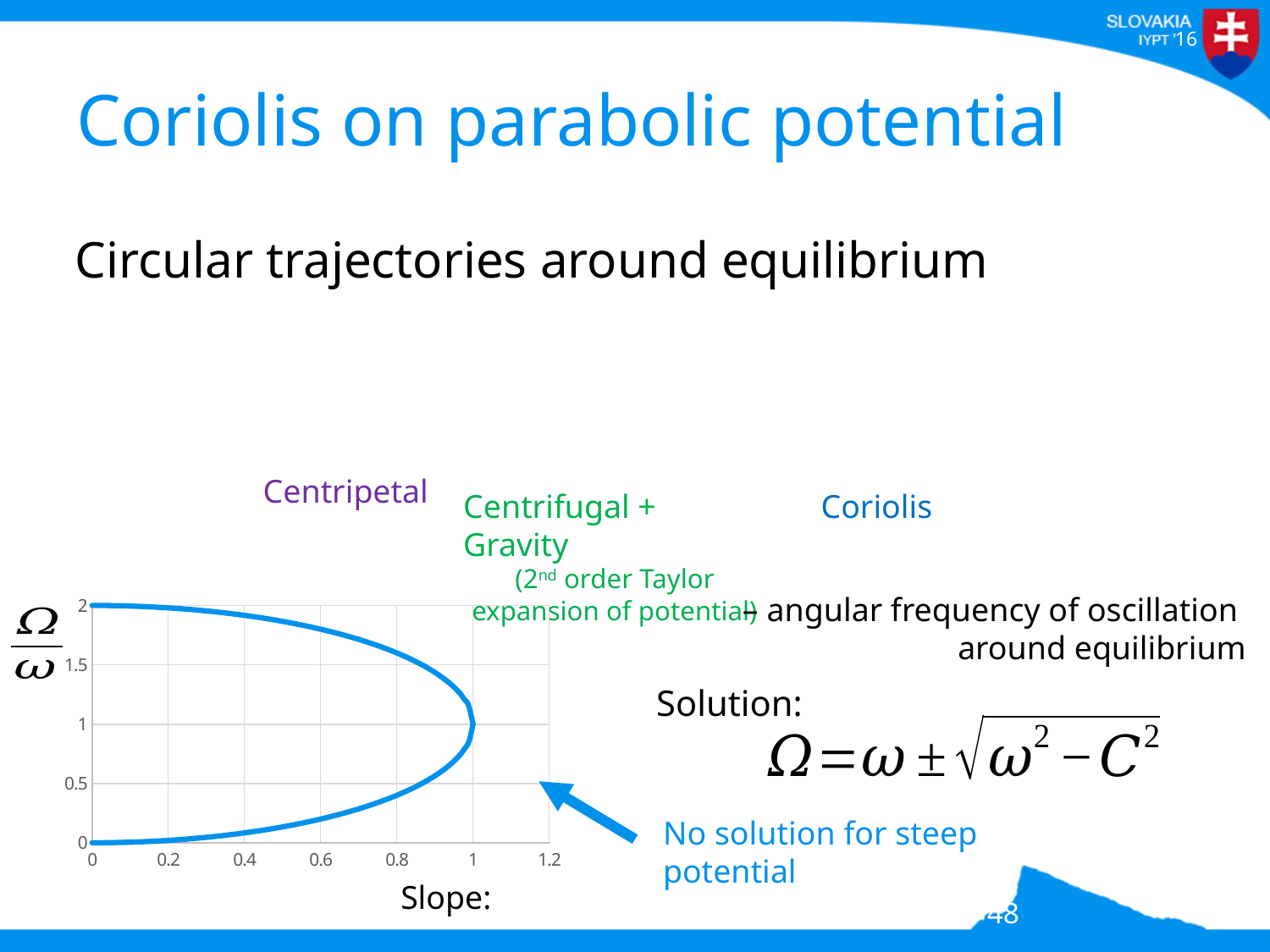
What is the value of Ω/ω where the two branches of the curve meet? 1 What is the highest value shown on the y axis of the chart? 2 Is the value of the lower branch of the curve at slope 0.5 greater or less than 0.5? less How many tick labels are shown on the x axis of the chart? 7 What is the largest tick value shown on the x axis of the chart? 1.2 What is the minimum value of Ω/ω reached by the curve? 0 Does the upper branch of the curve rise or fall as the slope increases from 0 to 1? fall What is the label of the x axis of the chart? Slope: At what slope value does the upper and lower branch of the curve meet? 1 What is the maximum value of Ω/ω reached by the curve? 2 Is the value of the upper branch of the curve at slope 0.5 greater or less than 1.5? greater What kind of chart is shown on the slide? line chart